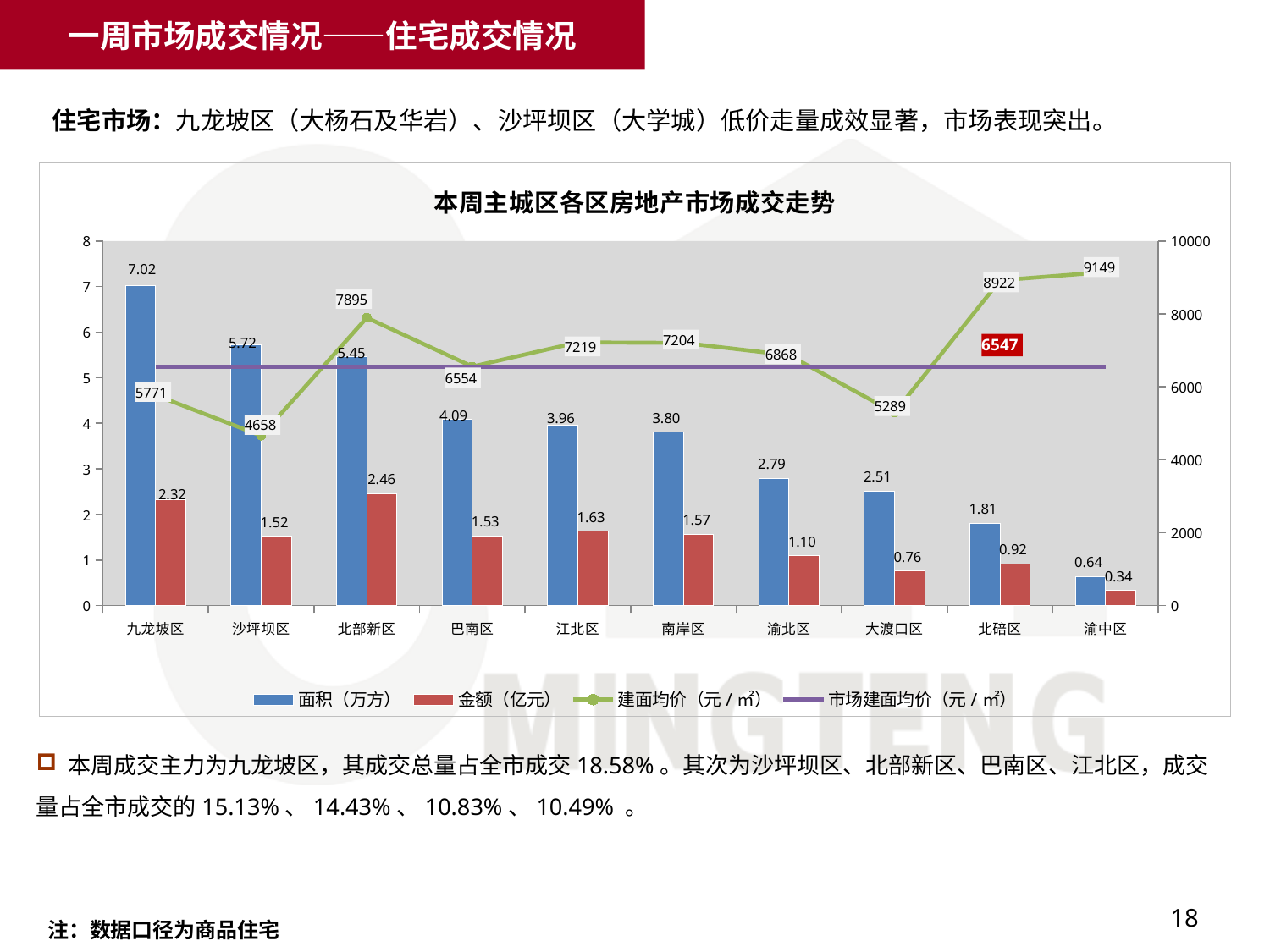
What is the difference between the 面积（万方） values of 九龙坡区 and 沙坪坝区? 1.30 What is the 金额（亿元） value for 北部新区? 2.46 What is the 面积（万方） value for 九龙坡区? 7.02 What is the 建面均价（元/㎡） value for 渝中区? 9149 How many series does the chart legend list? 4 What is the title of the chart? 本周主城区各区房地产市场成交走势 Which district has the lowest 建面均价（元/㎡） value? 沙坪坝区 How many districts (categories) are shown on the x axis? 10 Which is larger, the 金额（亿元） value for 北部新区 or for 九龙坡区? 北部新区 Which district has the highest 建面均价（元/㎡） value? 渝中区 What is the value of the 市场建面均价（元/㎡） line? 6547 Which district has the lowest 面积（万方） value? 渝中区